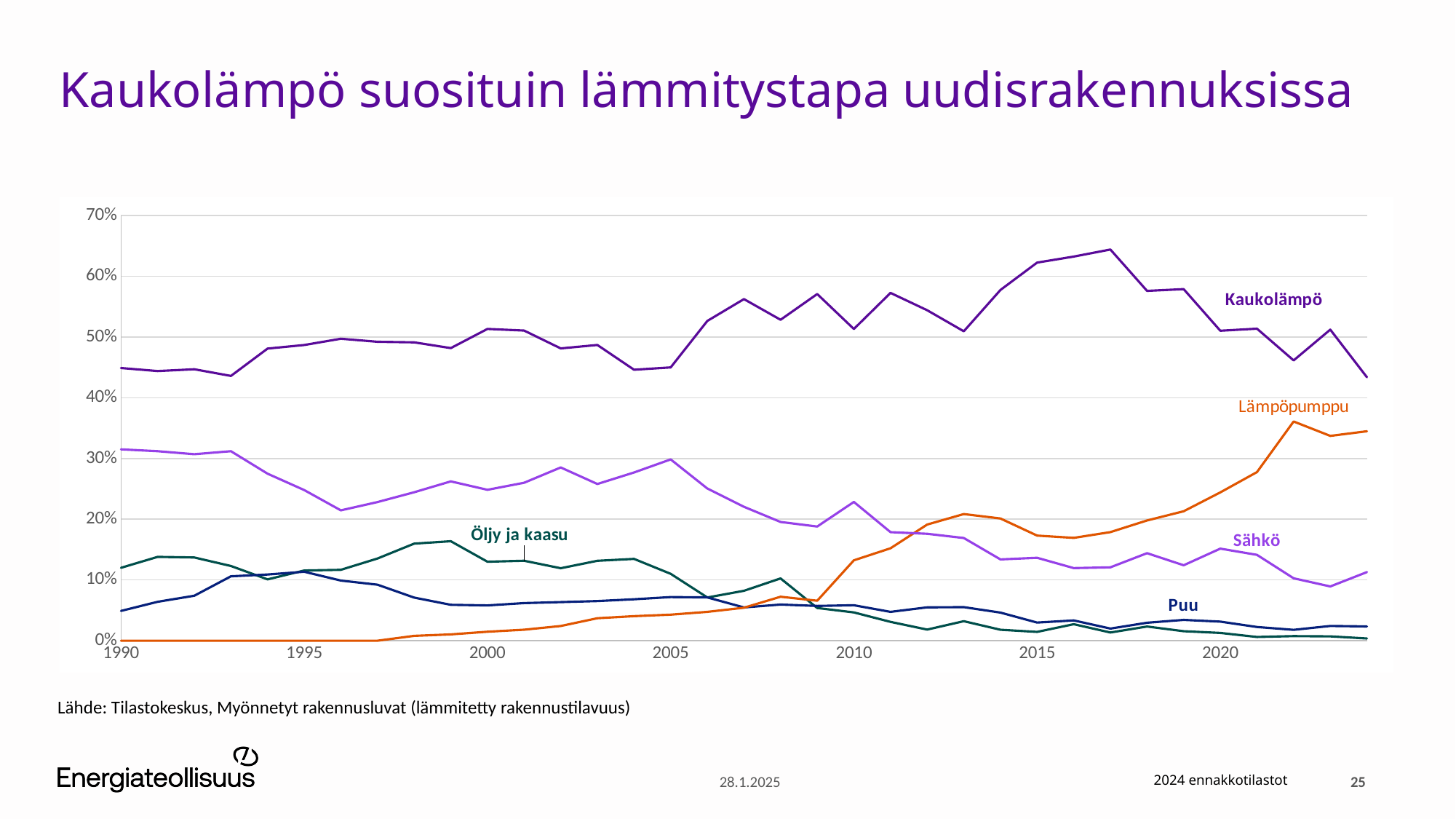
How many series are plotted in the chart? 5 Is the value for Sähkö in 1990 greater or less than 20%? greater In 1990, which is larger, Sähkö or Öljy ja kaasu? Sähkö What is the title of the slide? Kaukolämpö suosituin lämmitystapa uudisrakennuksissa Is the value for Lämpöpumppu in 2022 greater or less than 30%? greater Does the Lämpöpumppu series generally rise or fall from 2010 to 2024? rise Is the value for Öljy ja kaasu in 2024 greater or less than 10%? less In 2024, which is larger, Lämpöpumppu or Sähkö? Lämpöpumppu Which series has the lowest value in 2024? Öljy ja kaasu What kind of chart is shown on the slide? line chart Which series has the highest value in 2024? Kaukolämpö